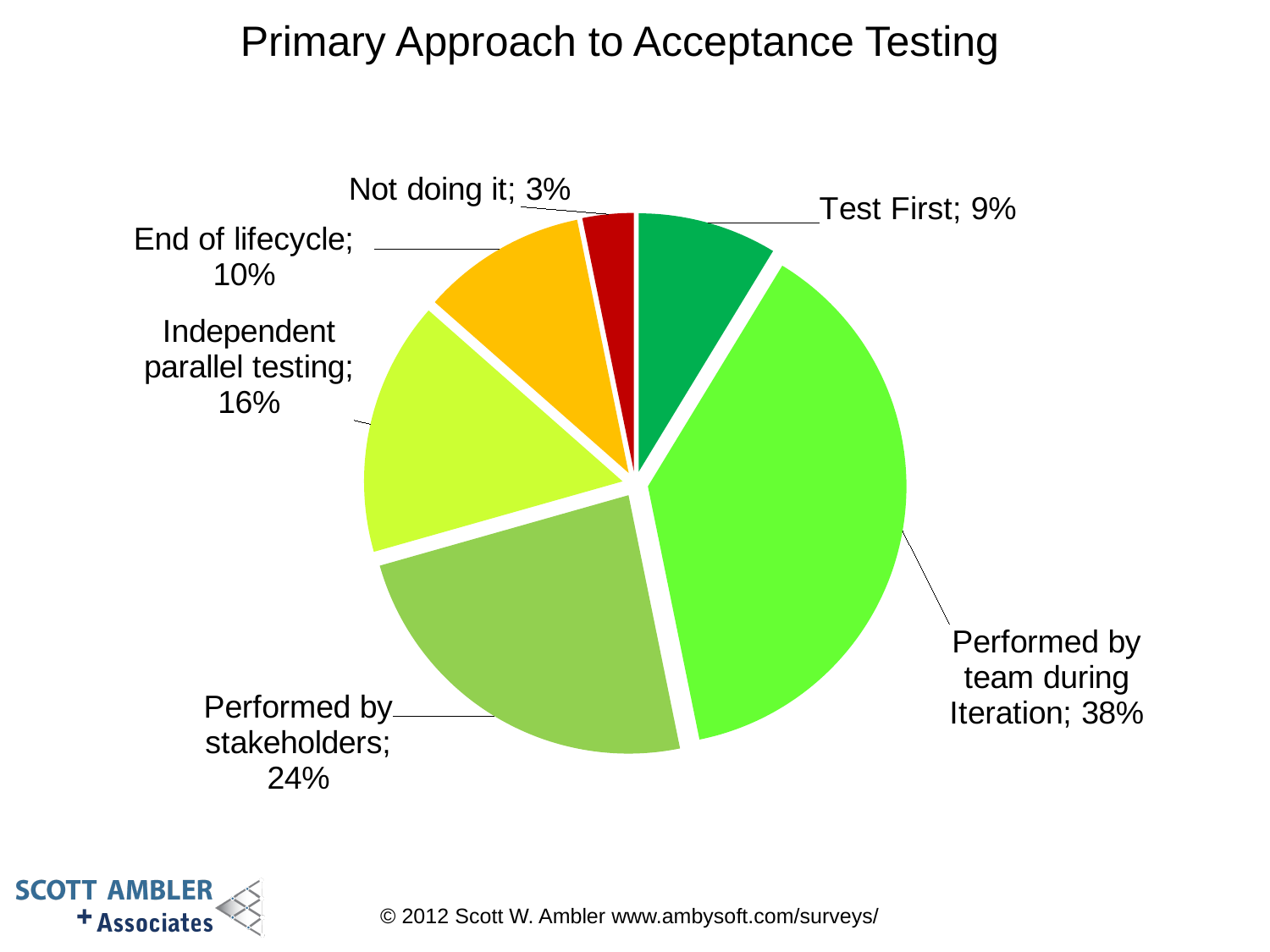
What percentage is shown for 'Performed by stakeholders'? 24% What percentage is shown for 'End of lifecycle'? 10% What kind of chart is shown on the slide? pie chart Which category has the smallest slice of the pie? Not doing it What is the title of the chart? Primary Approach to Acceptance Testing What percentage is shown for 'Test First'? 9% What percentage is shown for 'Independent parallel testing'? 16% Which is larger, 'Independent parallel testing' or 'End of lifecycle'? Independent parallel testing What is the difference in percentage points between 'Performed by team during Iteration' and 'Performed by stakeholders'? 14 Which category has the largest slice of the pie? Performed by team during Iteration What percentage is shown for 'Performed by team during Iteration'? 38% How many categories are shown in the pie chart? 6